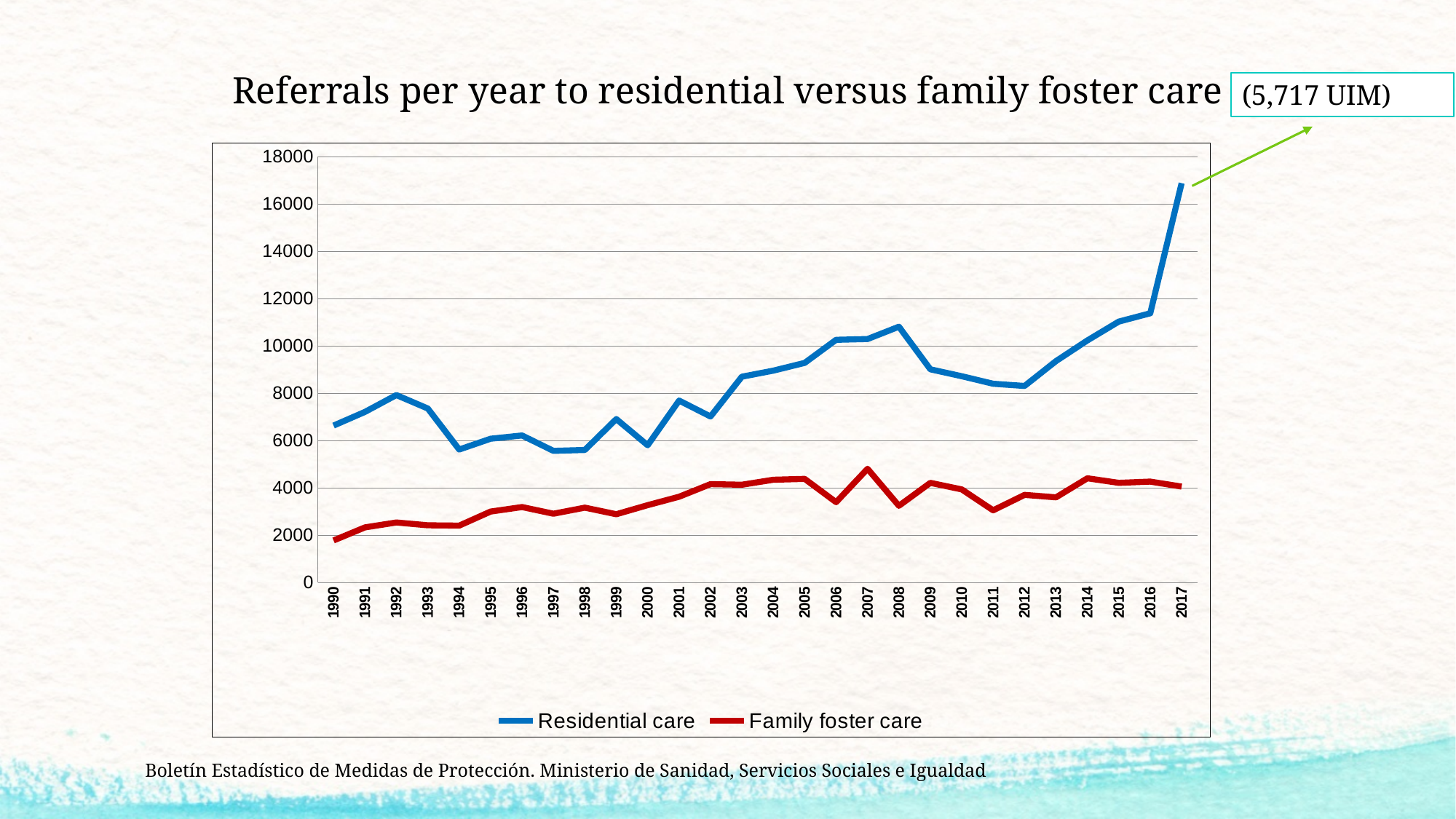
In which year is the Family foster care value highest? 2007 In which year is the Residential care value highest? 2017 How many series does the legend list? 2 What kind of chart is shown on the slide? line chart In which year is the Family foster care value lowest? 1990 Is the Family foster care value for 1990 greater or less than 2000? less What colour is the Residential care line? blue Which series has the larger value in 2000, Residential care or Family foster care? Residential care Is the Residential care value for 2008 greater or less than 10000? greater Is the Residential care value for 2017 greater or less than 16000? greater How many years are shown on the x axis? 28 Does the Family foster care line rise or fall overall from 1990 to 2017? rise